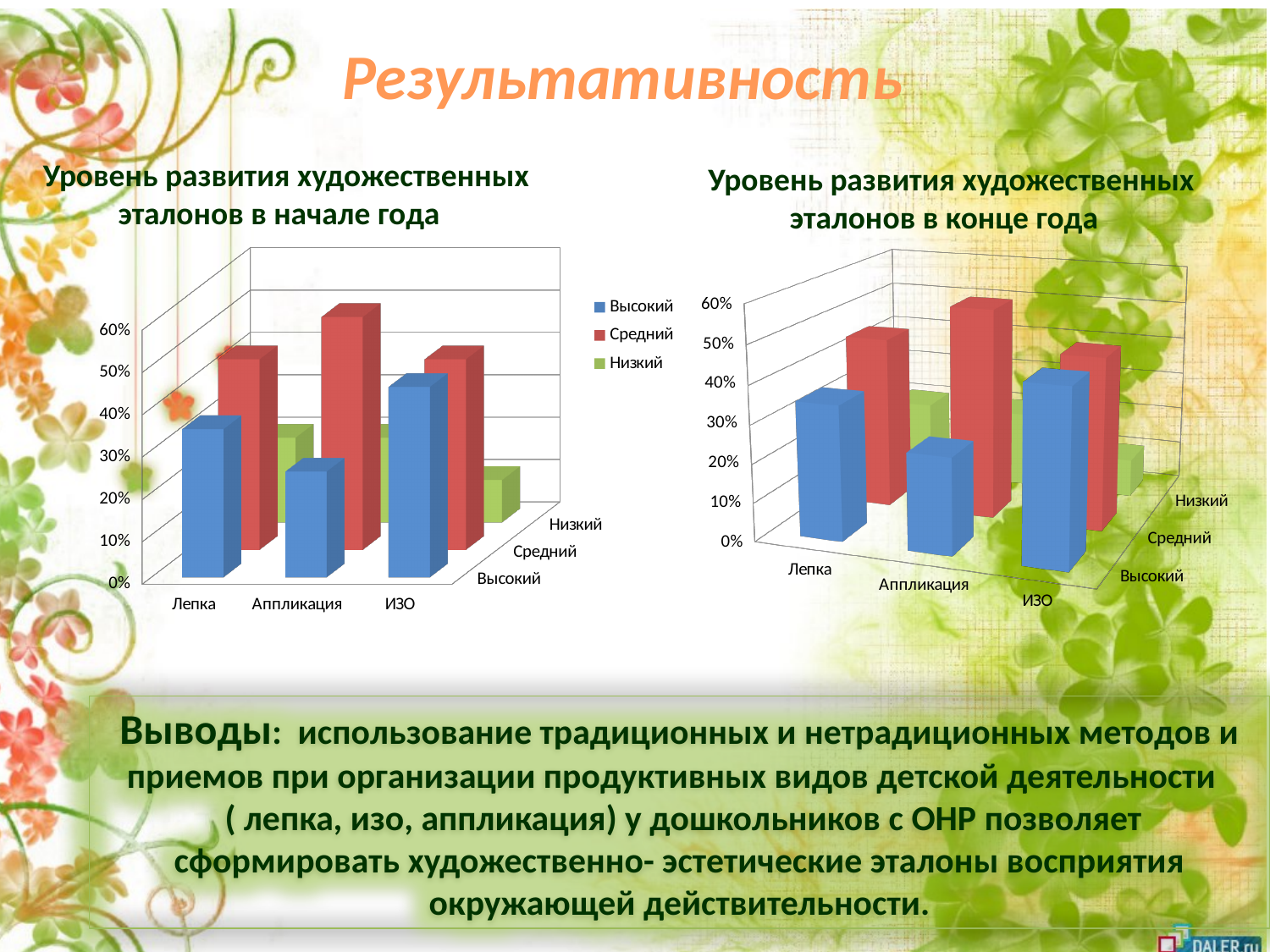
How many series does the legend of the left chart list? 3 How many categories are shown on the x axis of the right chart, 'Уровень развития художественных эталонов в конце года'? 3 In the left chart (начало года), which category has the highest value for the Высокий series? ИЗО In the left chart (начало года), which category has the lowest value for the Высокий series? Аппликация What are the series names listed in the legend of the left chart? Высокий, Средний, Низкий What kind of chart is the left chart, 'Уровень развития художественных эталонов в начале года'? bar chart In the left chart (начало года), is the Высокий value for Аппликация greater or less than 40%? less In the right chart (конец года), which category has the highest value for the Средний series? Аппликация In the right chart (конец года), which category has the lowest value for the Высокий series? Аппликация In the right chart (конец года), which is larger for the Высокий series: Лепка or ИЗО? ИЗО What are the category labels on the x axis of the left chart? Лепка, Аппликация, ИЗО In the right chart (конец года), is the Высокий value for ИЗО greater or less than 30%? greater